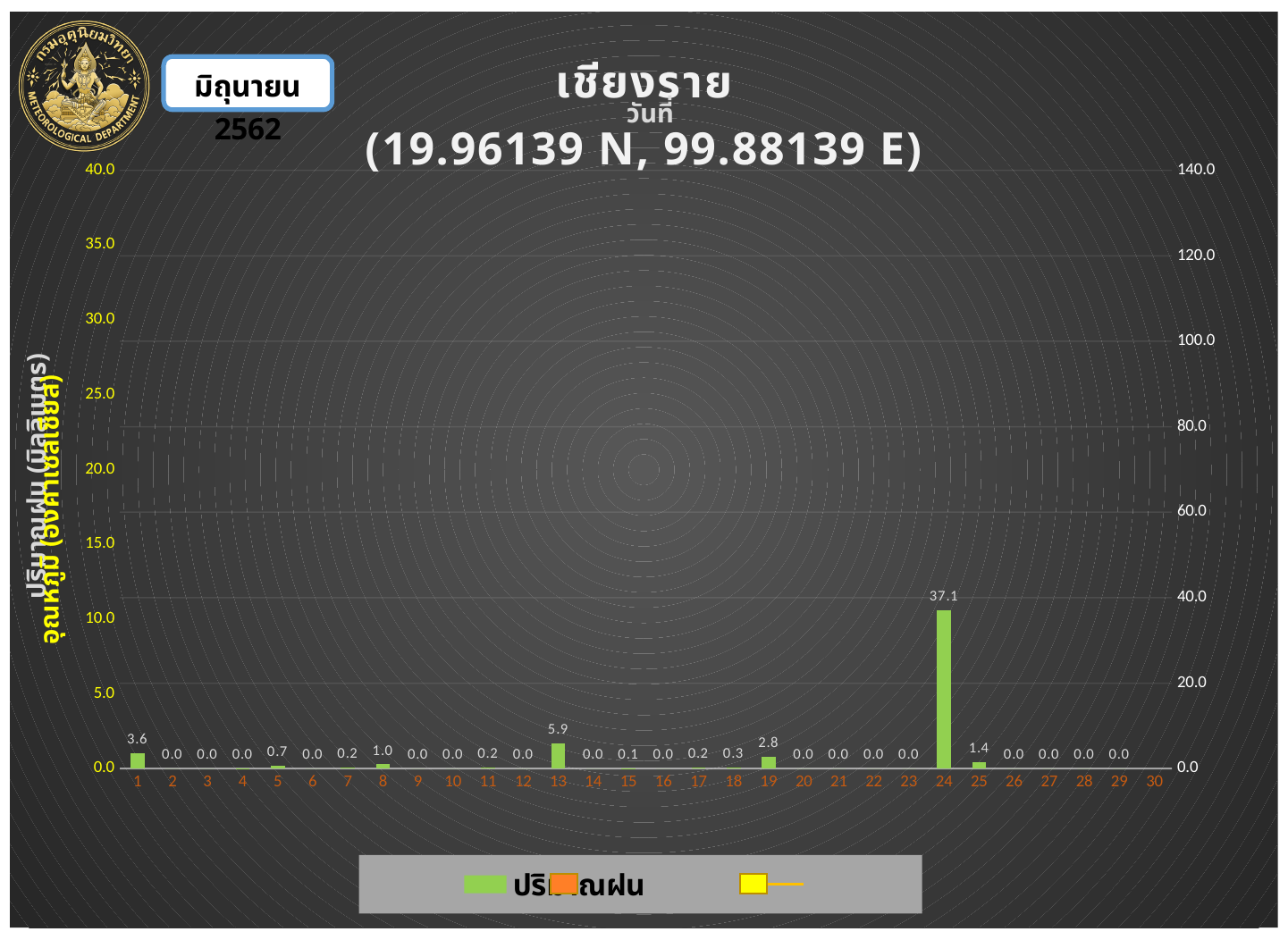
What is the rainfall value shown for day 19? 2.8 What kind of chart is shown on the slide? bar chart What is the difference between the rainfall values for day 24 and day 13? 31.2 What coordinates are given in the chart title? 19.96139 N, 99.88139 E What is the difference between the rainfall values for day 13 and day 1? 2.3 How many days are shown on the x axis? 30 What is the rainfall value shown for day 25? 1.4 What is the rainfall value shown for day 24? 37.1 What is the rainfall value shown for day 13? 5.9 Which is larger, the rainfall value for day 8 or for day 19? day 19 Which day has the highest rainfall value? 24 What is the rainfall value shown for day 1? 3.6